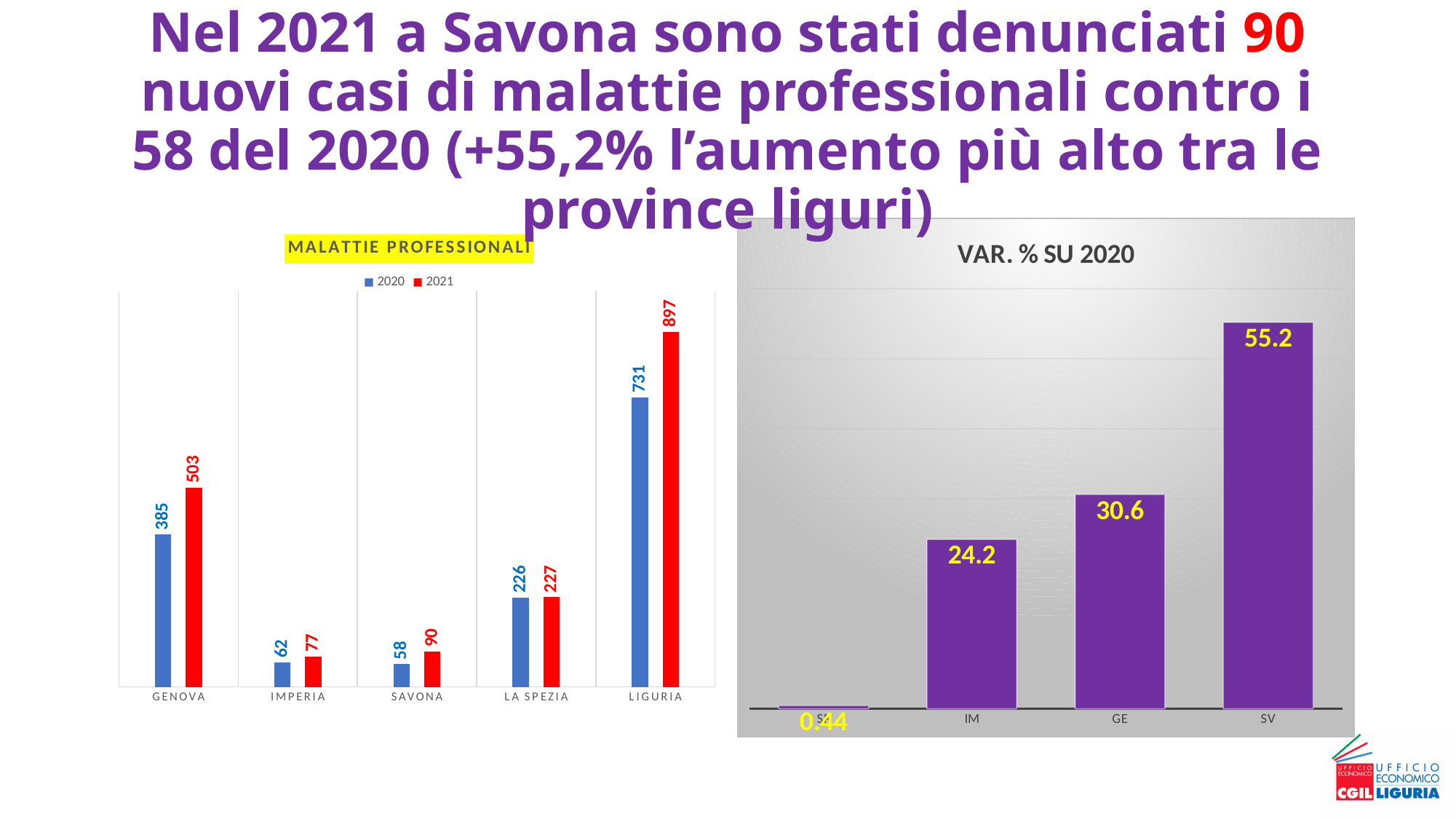
In the VAR. % SU 2020 chart, what is the value for GE? 30.6 In the MALATTIE PROFESSIONALI chart, which category has the highest 2021 value? Liguria In the MALATTIE PROFESSIONALI chart, which category has the lowest 2020 value? Savona In the MALATTIE PROFESSIONALI chart, what is the difference between the 2021 and 2020 values for Genova? 118 How many series does the legend of the MALATTIE PROFESSIONALI chart list? 2 In the VAR. % SU 2020 chart, which category has the highest value? SV In the MALATTIE PROFESSIONALI chart, which is larger for Imperia: the 2020 value or the 2021 value? 2021 In the MALATTIE PROFESSIONALI chart, what is the 2021 value for Savona? 90 How many categories are shown on the x axis of the MALATTIE PROFESSIONALI chart? 5 In the VAR. % SU 2020 chart, what is the value for SV? 55.2 In the MALATTIE PROFESSIONALI chart, what is the 2020 value for Genova? 385 What kind of chart is the VAR. % SU 2020 chart? Bar chart